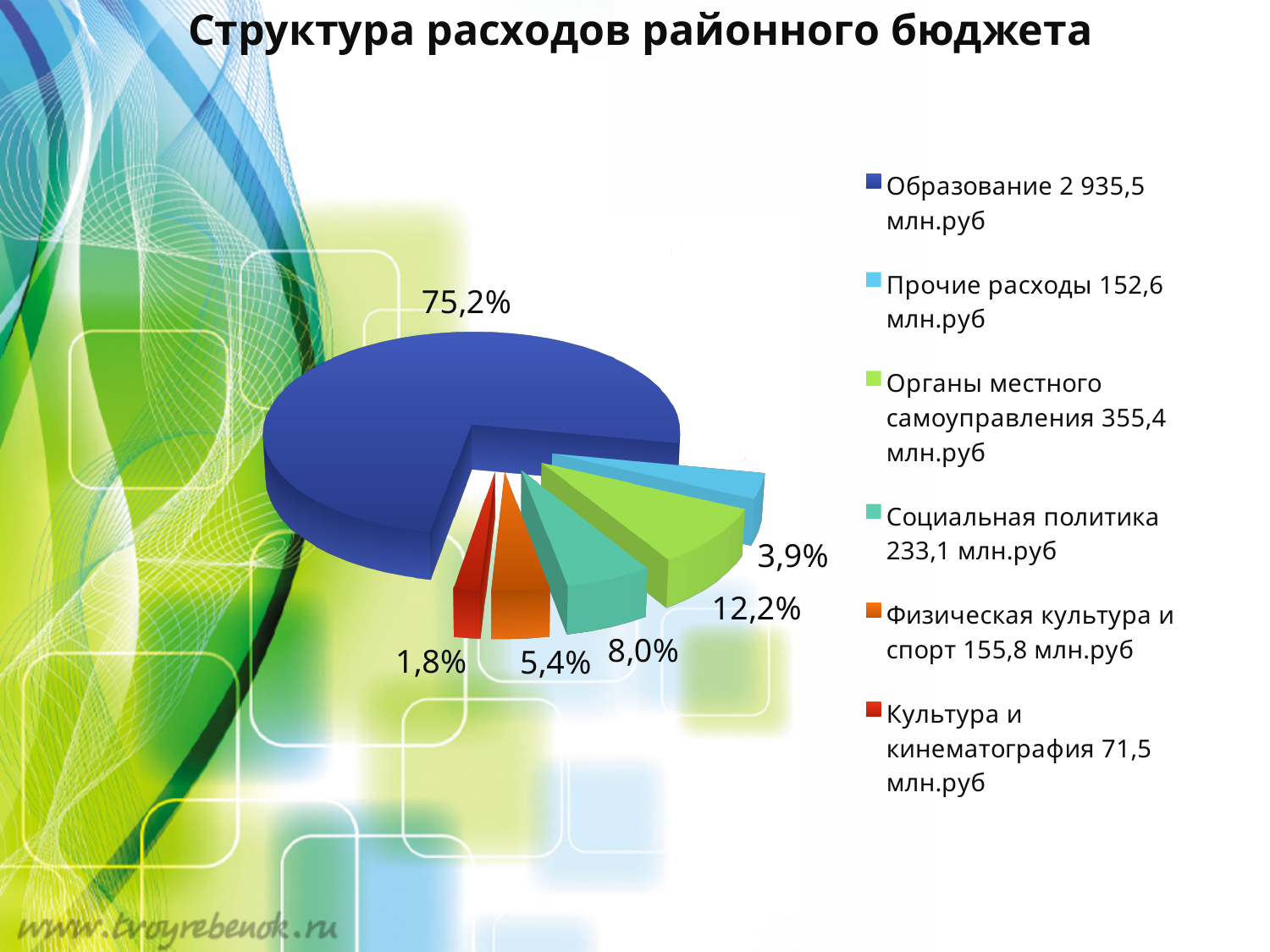
What is the difference in percentage points between the share for Органы местного самоуправления and the share for Социальная политика? 4,2 Which category has the smallest slice of the pie? Культура и кинематография What is the title of the chart? Структура расходов районного бюджета Which category has the largest slice of the pie? Образование What kind of chart is shown on the slide? pie chart What share of the pie does Социальная политика take? 8,0% What share of the pie does Культура и кинематография take? 1,8% What share of the pie does Образование take? 75,2% How many slices does the pie chart have? 6 According to the legend, what is the amount for Социальная политика? 233,1 млн.руб Which is larger: the share for Физическая культура и спорт or the share for Прочие расходы? Физическая культура и спорт